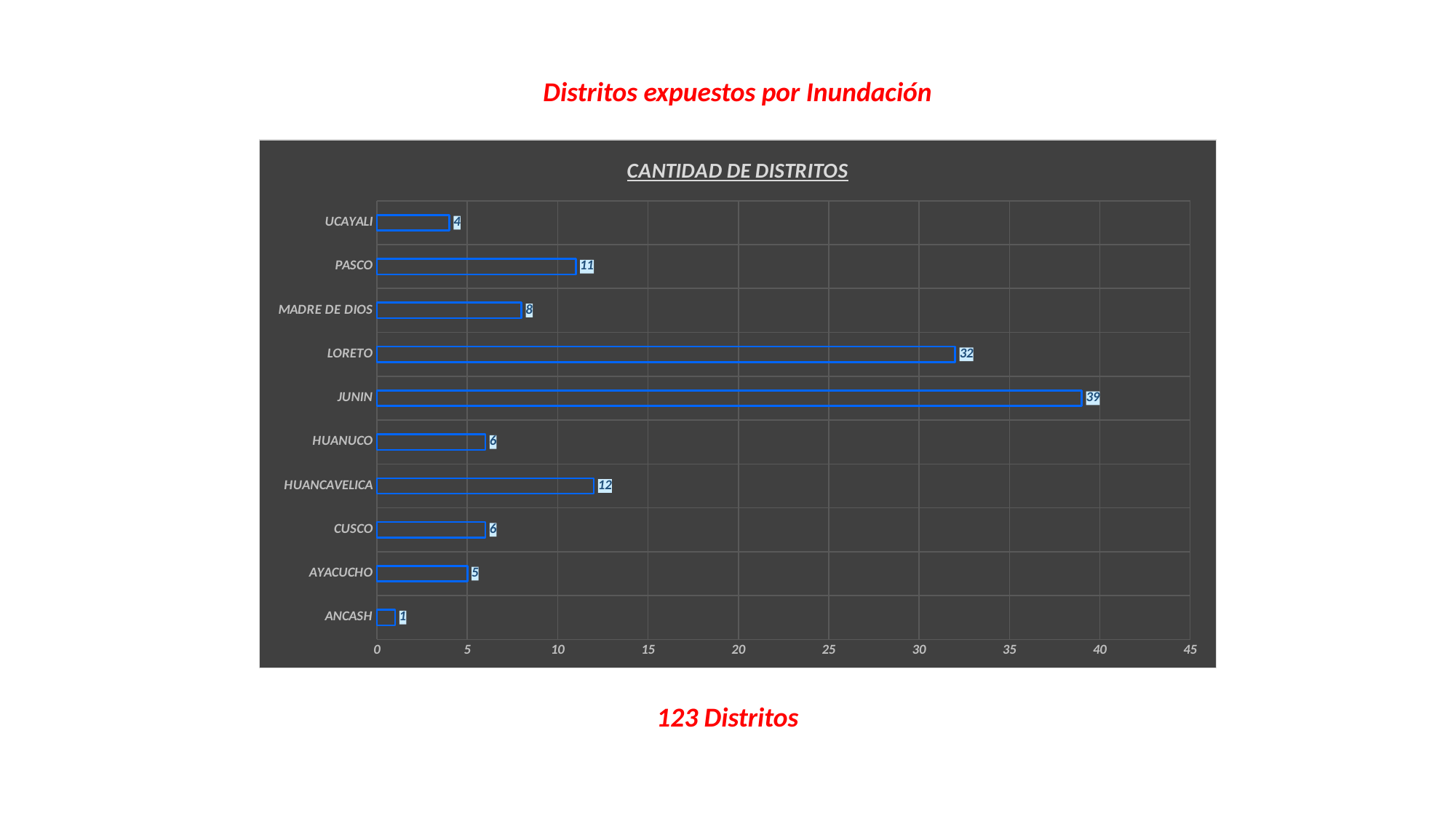
Is the value for LORETO greater or less than 30? greater How many categories are shown in the chart? 10 Which category has the highest value? JUNIN What is the difference between the values for JUNIN and LORETO? 7 What kind of chart is shown on the slide? bar chart What is the value for ANCASH? 1 What is the value for HUANCAVELICA? 12 Which category has the lowest value? ANCASH What is the value for JUNIN? 39 What is the title of the chart? CANTIDAD DE DISTRITOS Which is larger, the value for PASCO or the value for MADRE DE DIOS? PASCO What is the value for LORETO? 32